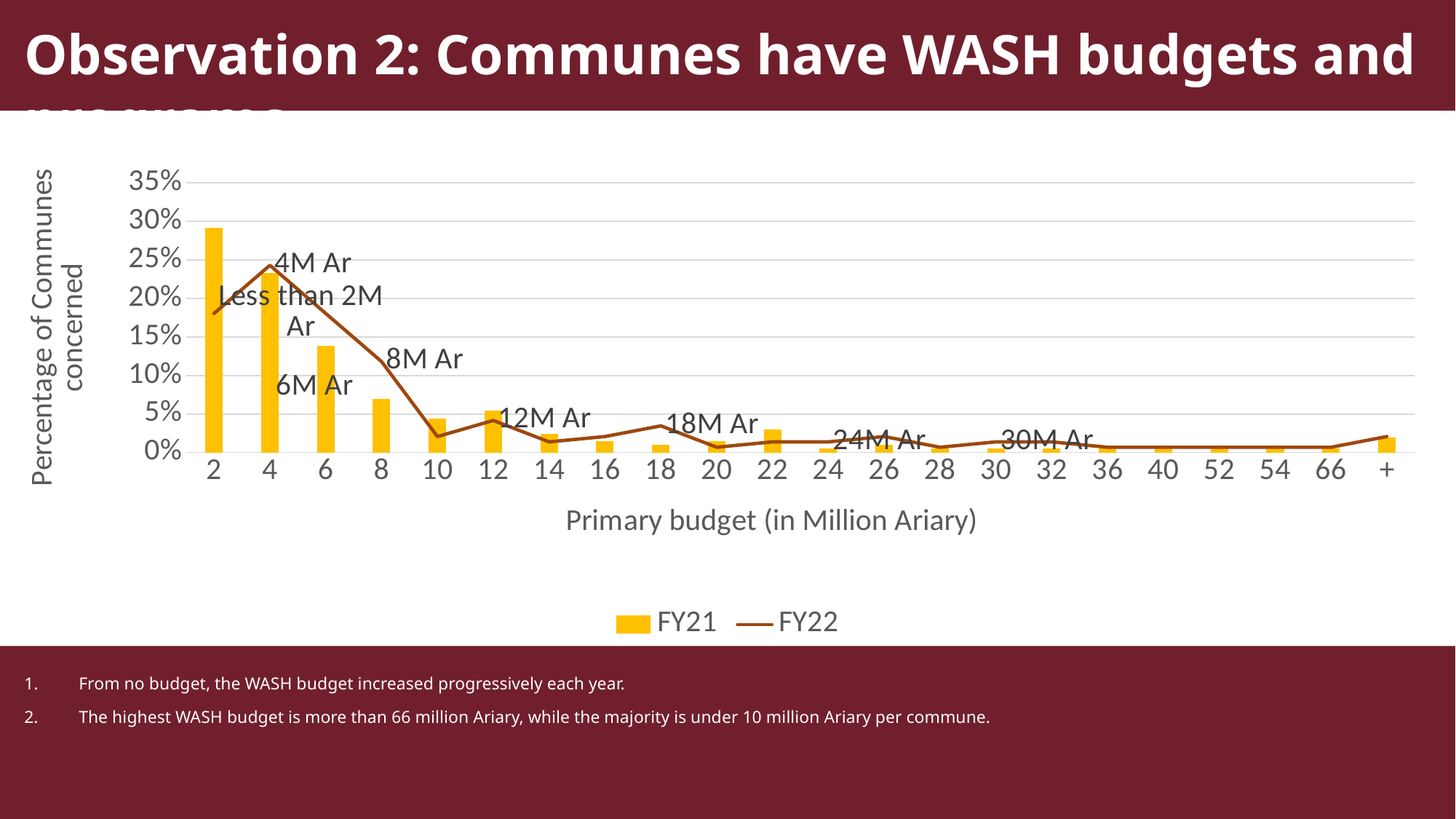
Which is larger for FY21: the value at 2 million Ariary or at 4 million Ariary? 2 million Ariary Do the FY21 bars rise or fall from the 2 million to the 10 million Ariary category? fall Which primary budget category has the highest FY21 bar? 2 How many series does the legend list? 2 What kind of chart is shown on the slide? A combined bar and line chart Which series is drawn as a line? FY22 Is the FY21 value for the 2 million Ariary category greater or less than 25%? greater Is the FY21 value for the 6 million Ariary category greater or less than 10%? greater Is the FY21 value for the 4 million Ariary category greater or less than 20%? greater How many primary budget categories are shown on the x axis? 22 At which primary budget category does the FY22 line reach its peak? 4